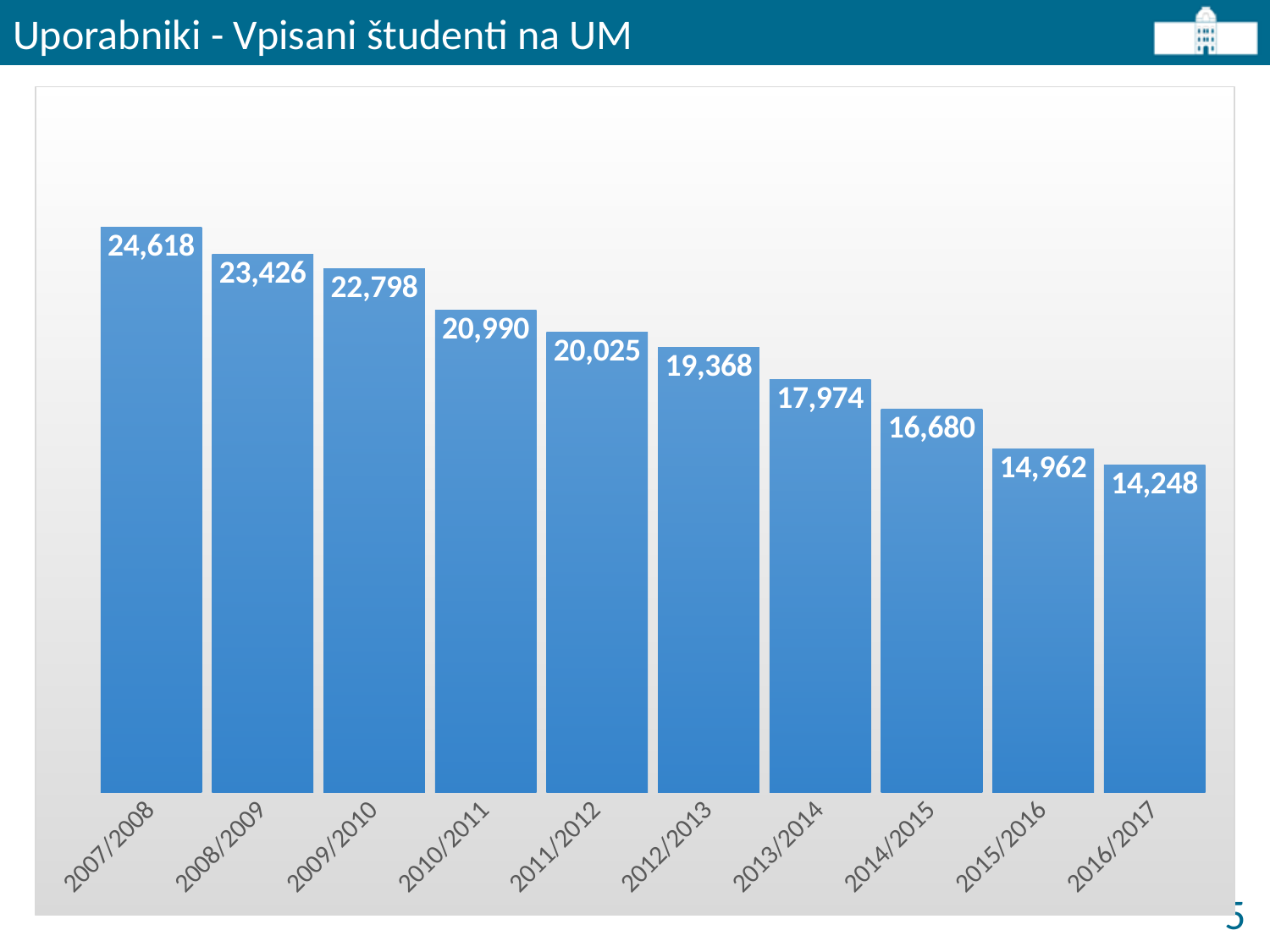
How many academic years are shown on the x axis? 10 What is the value for 2007/2008? 24,618 What is the title of the slide? Uporabniki - Vpisani študenti na UM Which is larger, the value for 2009/2010 or the value for 2013/2014? 2009/2010 What is the difference between the values for 2007/2008 and 2016/2017? 10,370 What is the difference between the values for 2010/2011 and 2011/2012? 965 Do the values rise or fall from 2007/2008 to 2016/2017? fall Which academic year has the highest value? 2007/2008 What is the value for 2012/2013? 19,368 What is the value for 2016/2017? 14,248 What kind of chart is shown on the slide? bar chart Which academic year has the lowest value? 2016/2017